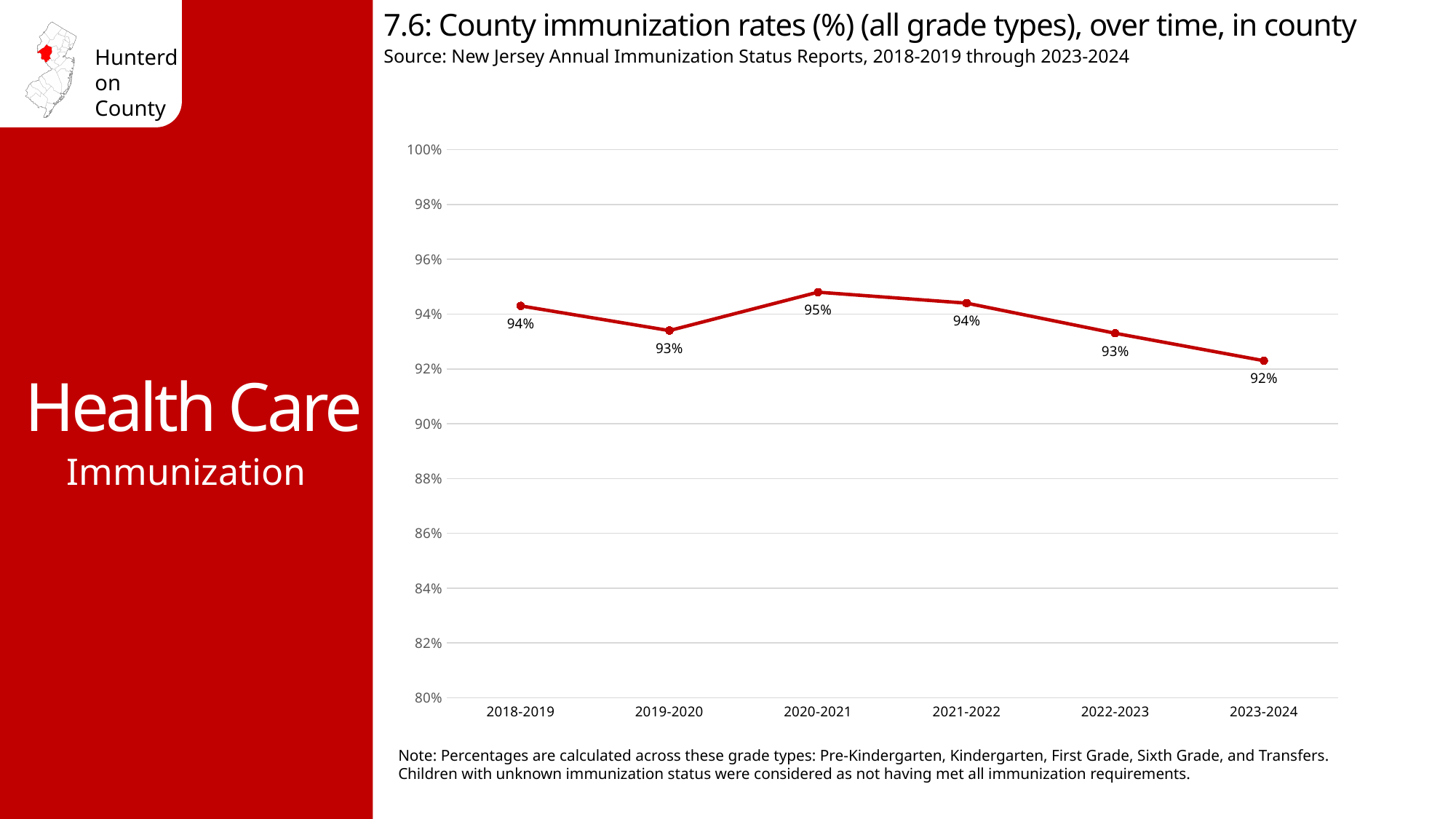
Is the immunization rate for 2023-2024 greater or less than 90%? greater Which is higher, the immunization rate in 2018-2019 or in 2019-2020? 2018-2019 Which school year has the lowest immunization rate? 2023-2024 From 2021-2022 to 2023-2024, do the immunization rates rise or fall? fall Which school year has the highest immunization rate? 2020-2021 What is the source cited for the chart data? New Jersey Annual Immunization Status Reports, 2018-2019 through 2023-2024 How many school years are plotted on the chart? 6 What is the difference between the immunization rate in 2020-2021 and in 2023-2024? 3 percentage points What is the county immunization rate for 2023-2024? 92% What is the county immunization rate for 2020-2021? 95% What kind of chart is shown on the slide? line chart What is the county immunization rate for 2018-2019? 94%